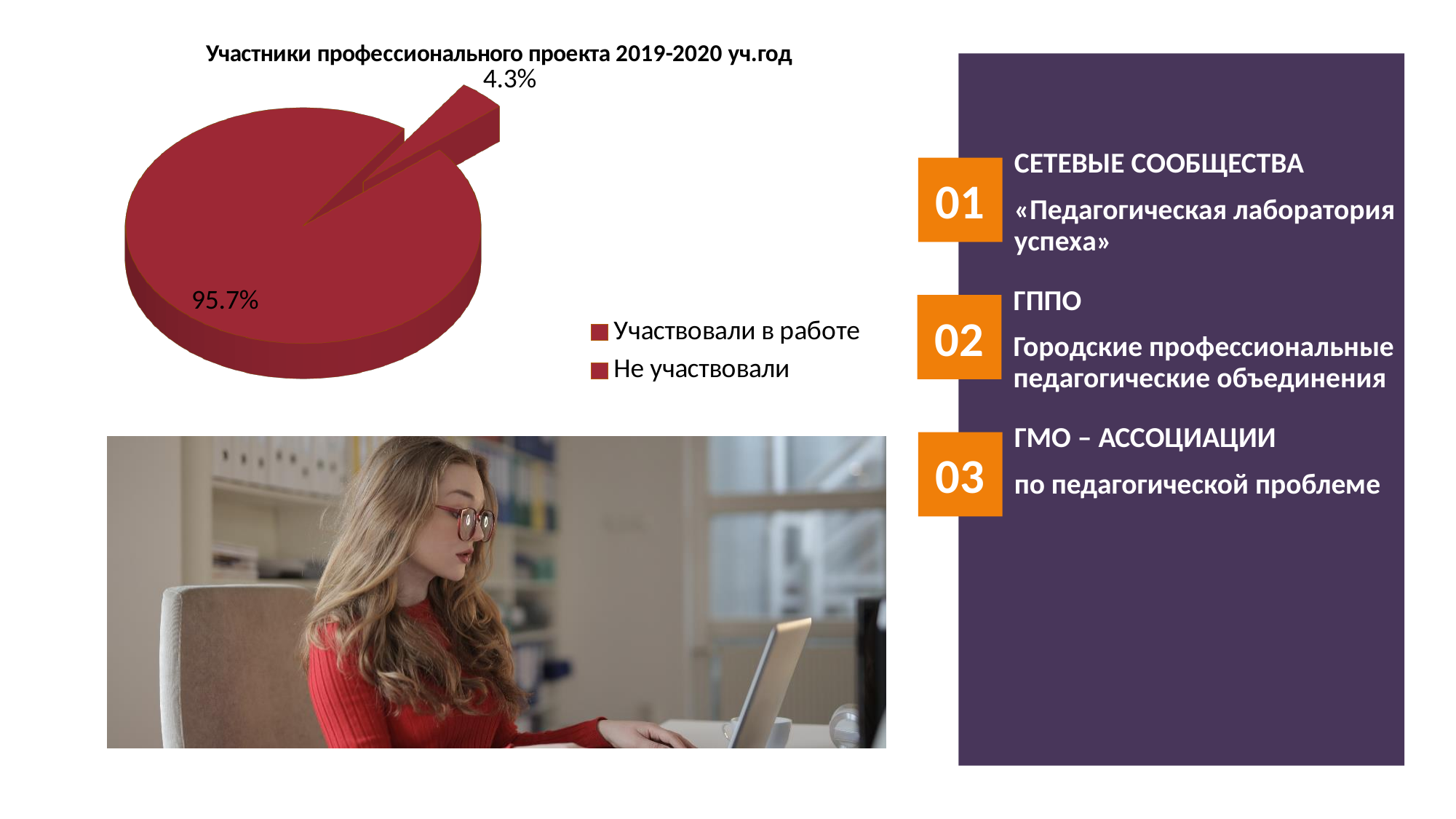
What kind of chart is shown on the slide? pie chart Which is larger: the share for "Участвовали в работе" or the share for "Не участвовали"? Участвовали в работе How many entries does the chart legend list? 2 Which category has the largest slice of the pie? Участвовали в работе What share of the pie is labelled for "Не участвовали"? 4.3% What is the title of the chart? Участники профессионального проекта 2019-2020 уч.год What is the total of the two percentage labels shown on the pie chart? 100% Which category has the smallest slice of the pie? Не участвовали How many slices does the pie chart have? 2 What is the difference in percentage points between the "Участвовали в работе" slice and the "Не участвовали" slice? 91.4 Which slice of the pie is pulled out (exploded) from the rest? Не участвовали What share of the pie is labelled for "Участвовали в работе"? 95.7%